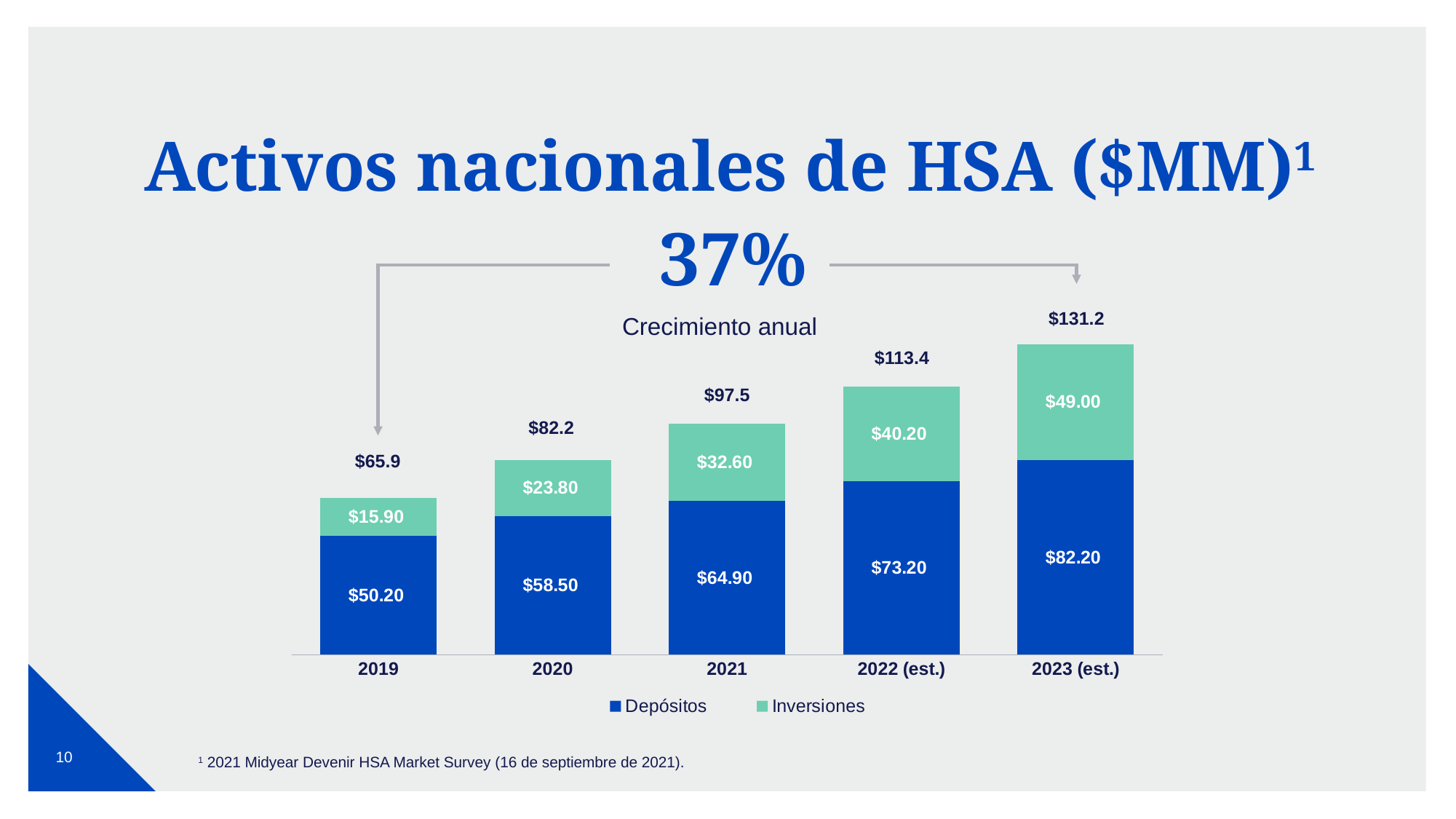
Which is larger: the Depósitos value for 2021 or the Inversiones value for 2023 (est.)? Depósitos for 2021 What is the difference between the Inversiones values for 2023 (est.) and 2022 (est.)? $8.80 What is the Inversiones value for 2022 (est.)? $40.20 Which year has the highest Inversiones value? 2023 (est.) What is the Depósitos value for 2019? $50.20 How many years are shown on the x axis? 5 What is the difference between the Depósitos values for 2020 and 2019? $8.30 What is the total of the stacked bar for 2023 (est.)? $131.2 What is the total of the stacked bar for 2021? $97.5 Do the total values rise or fall from 2019 to 2023 (est.)? rise Which year has the lowest Depósitos value? 2019 How many series does the legend list? 2